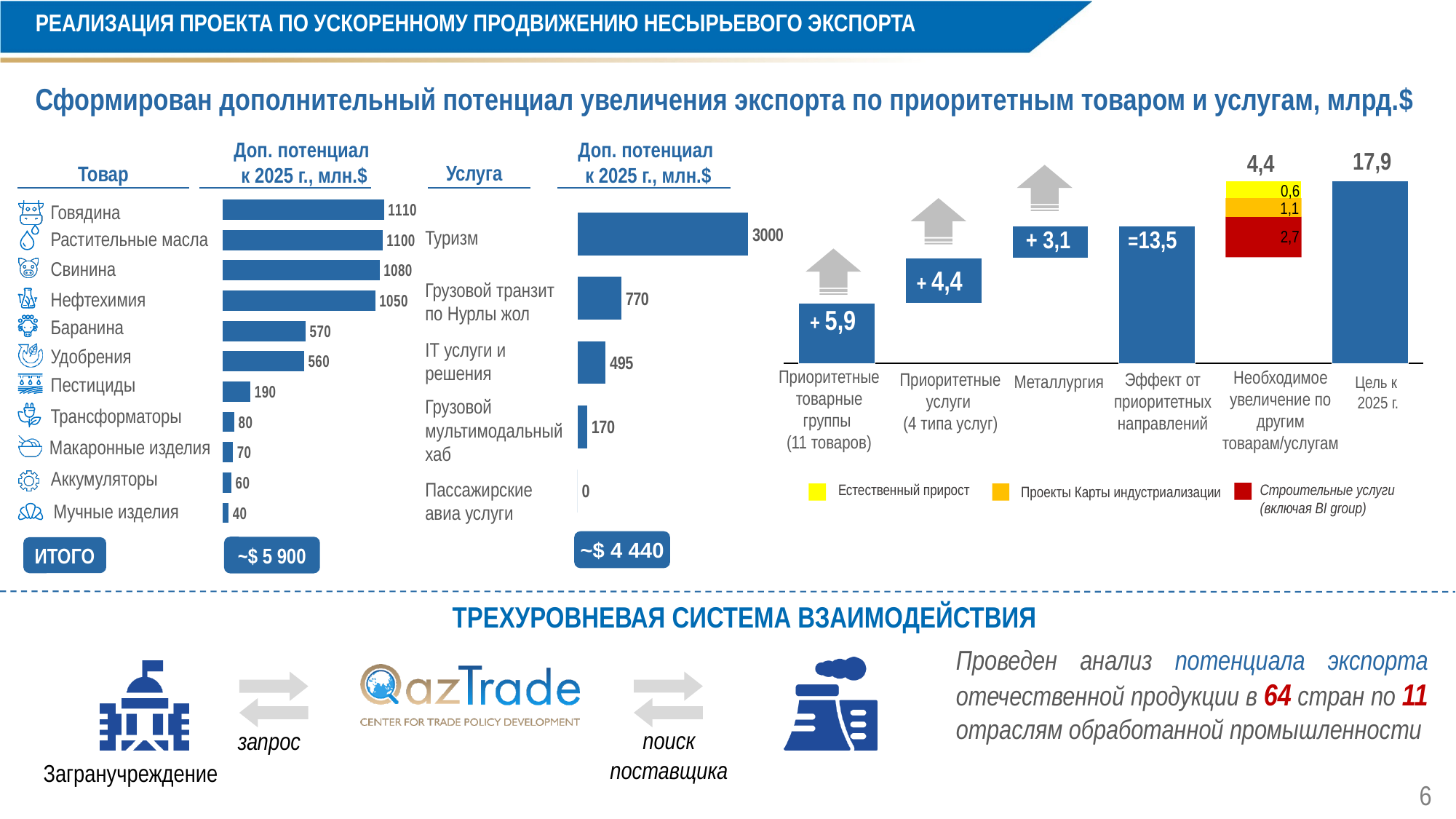
In the 'Товар' chart on the left, which product has the lowest additional potential? Мучные изделия In the chart on the right, what is the value for Металлургия? + 3,1 In the 'Услуга' chart in the middle, which is larger: Грузовой транзит по Нурлы жол or IT услуги и решения? Грузовой транзит по Нурлы жол In the 'Услуга' chart in the middle, what is the value for Туризм? 3000 In the chart on the right, what is the total of the stacked bar for 'Необходимое увеличение по другим товарам/услугам'? 4,4 In the 'Товар' chart on the left, what is the additional potential to 2025 for Говядина? 1110 In the 'Товар' chart on the left, what is the difference between the values for Баранина and Удобрения? 10 In the 'Услуга' chart in the middle, which service has the highest additional potential? Туризм In the 'Услуга' chart in the middle, what is the value for Пассажирские авиа услуги? 0 What type of chart is the 'Товар' chart on the left? Bar chart In the chart on the right, how many entries does the legend list? 3 In the 'Товар' chart on the left, how many products are listed? 11